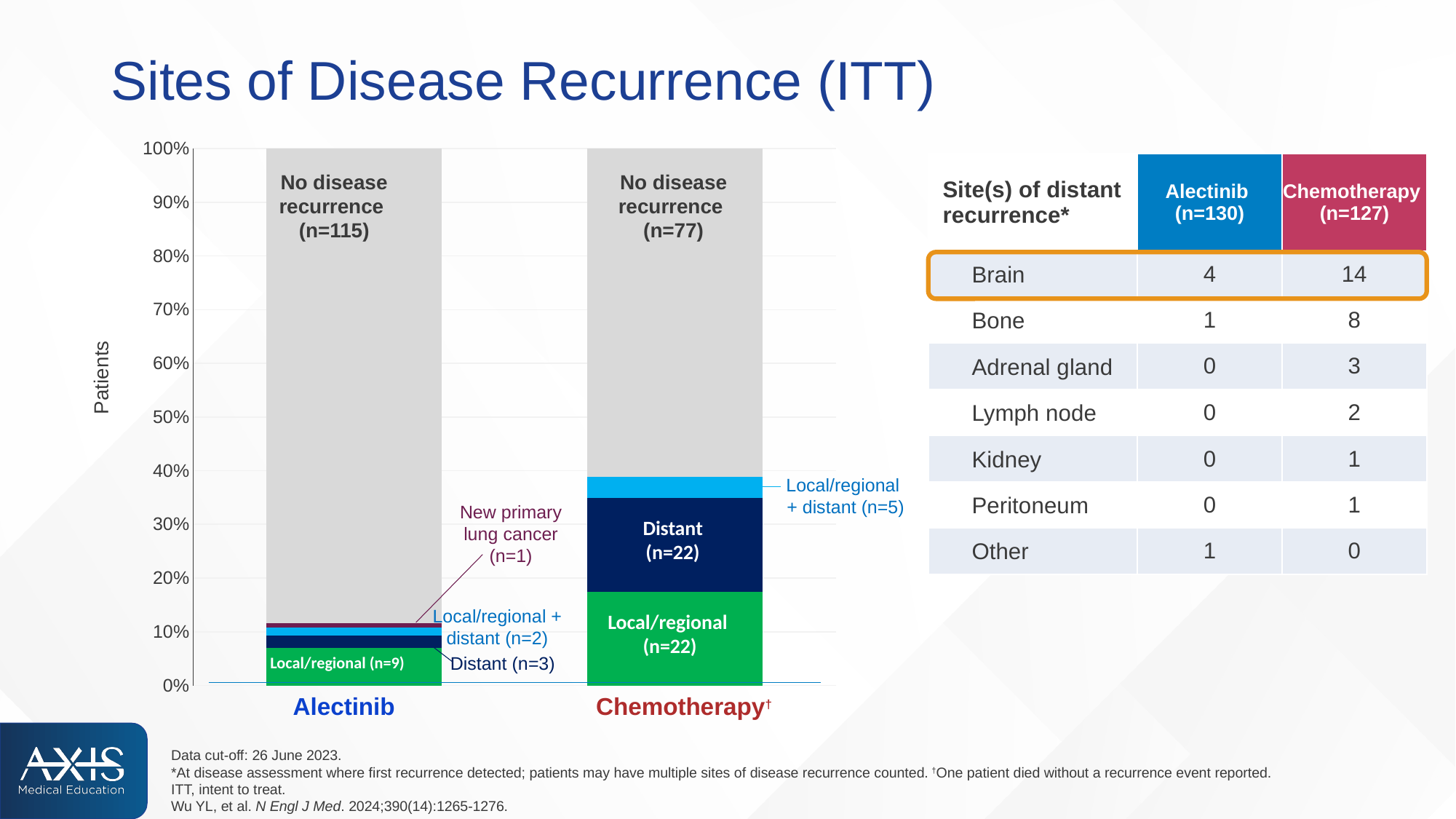
How many more patients had Distant recurrence in the Chemotherapy arm than in the Alectinib arm? 19 How many Alectinib patients had a new primary lung cancer? n=1 How many Chemotherapy patients had no disease recurrence according to the chart? n=77 How many Alectinib patients had no disease recurrence according to the chart? n=115 What kind of chart is shown on the slide? Stacked bar chart Which arm had more patients with no disease recurrence, Alectinib or Chemotherapy? Alectinib What is the total number of patients represented by all segments of the Alectinib bar? 130 What is the number of patients in the Distant segment of the Chemotherapy bar? n=22 What is the number of patients in the Local/regional segment of the Alectinib bar? n=9 How many treatment arms (bars) are plotted in the chart? 2 Is the proportion of Chemotherapy patients with no disease recurrence greater or less than 50%? greater How many Chemotherapy patients had Local/regional + distant recurrence? n=5